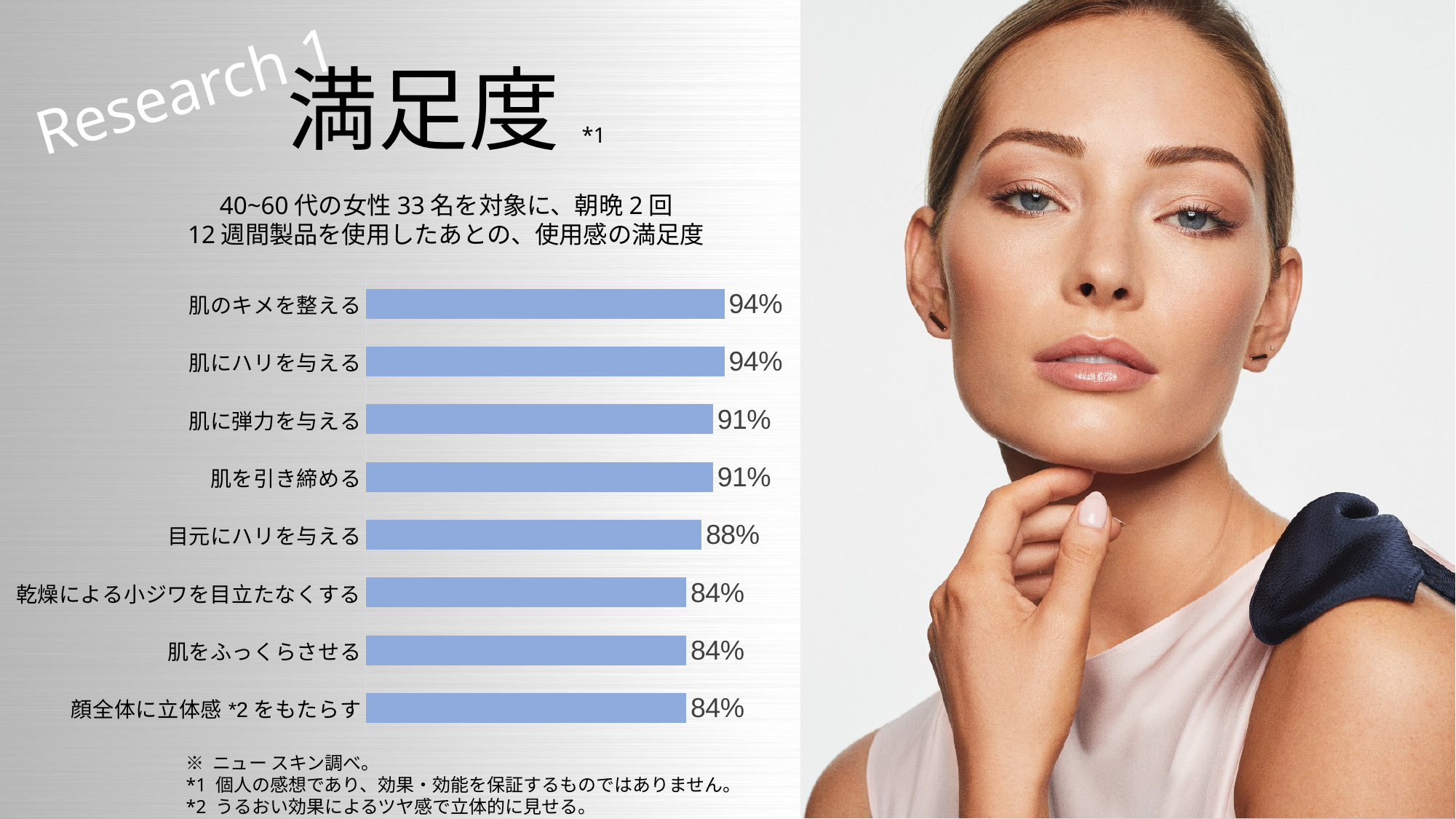
How many categories are shown in the chart? 8 What is the difference between the values for 肌に弾力を与える and 目元にハリを与える? 3% What is the satisfaction value for 目元にハリを与える? 88% What is the highest value shown in the chart? 94% What is the difference between the values for 肌にハリを与える and 肌をふっくらさせる? 10% What is the satisfaction value for 肌を引き締める? 91% What is the lowest value shown in the chart? 84% How many categories have a value of 84%? 3 Which has a larger value, 肌のキメを整える or 顔全体に立体感をもたらす? 肌のキメを整える What kind of chart is shown on the slide? Bar chart What is the satisfaction value for 乾燥による小ジワを目立たなくする? 84% What is the satisfaction value for 肌のキメを整える? 94%